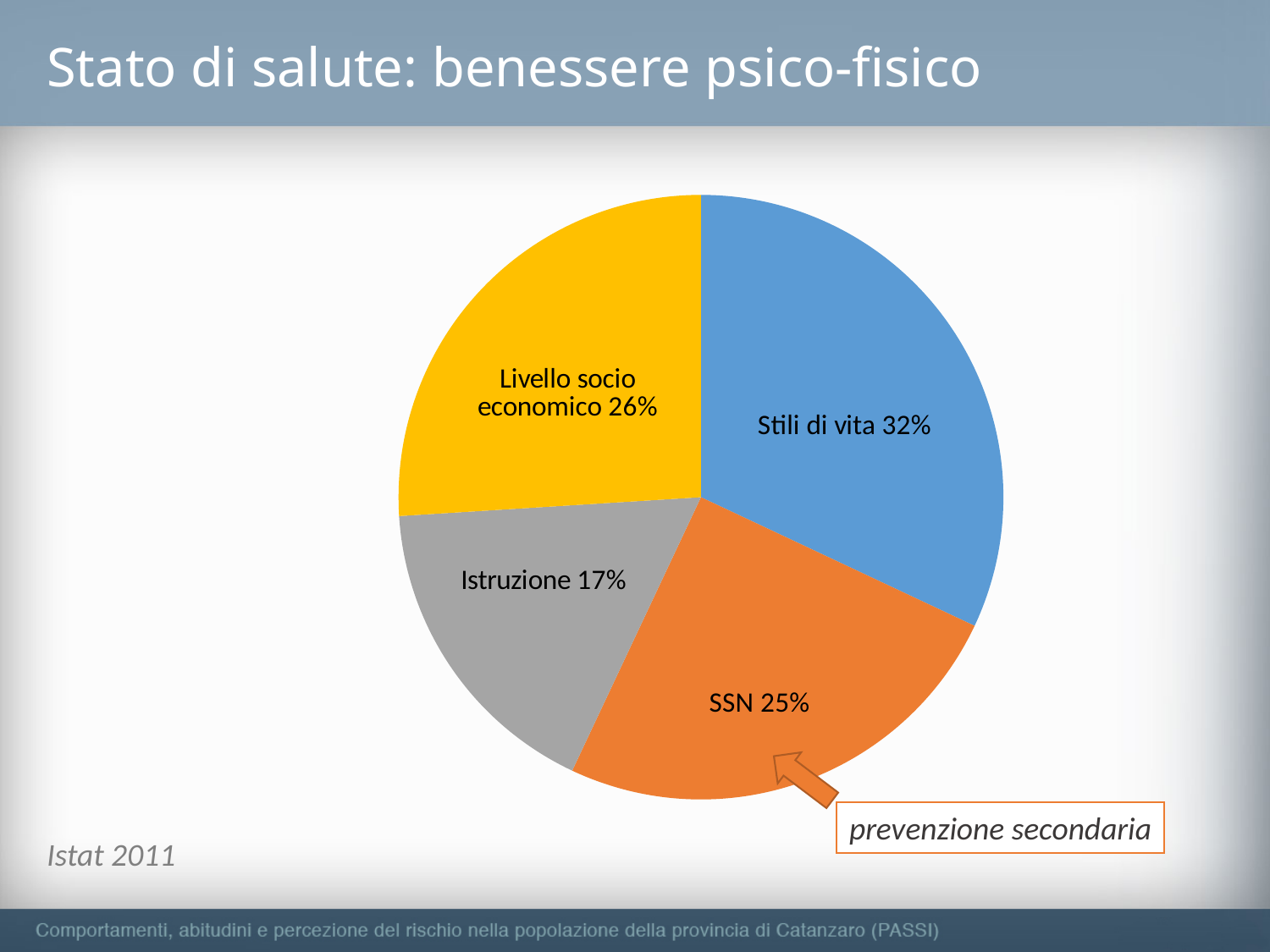
What is the share for Livello socio economico? 26% What is the share for Istruzione? 17% What is the share for Stili di vita? 32% What is the difference between the shares of Stili di vita and Istruzione? 15% Which is larger, the share for SSN or the share for Istruzione? SSN What is the difference between the shares of Livello socio economico and SSN? 1% How many slices does the pie chart have? 4 What is the share for SSN? 25% Which slice does the arrow labelled 'prevenzione secondaria' point to? SSN Which slice has the largest share? Stili di vita Which slice has the smallest share? Istruzione What kind of chart is shown on the slide? pie chart